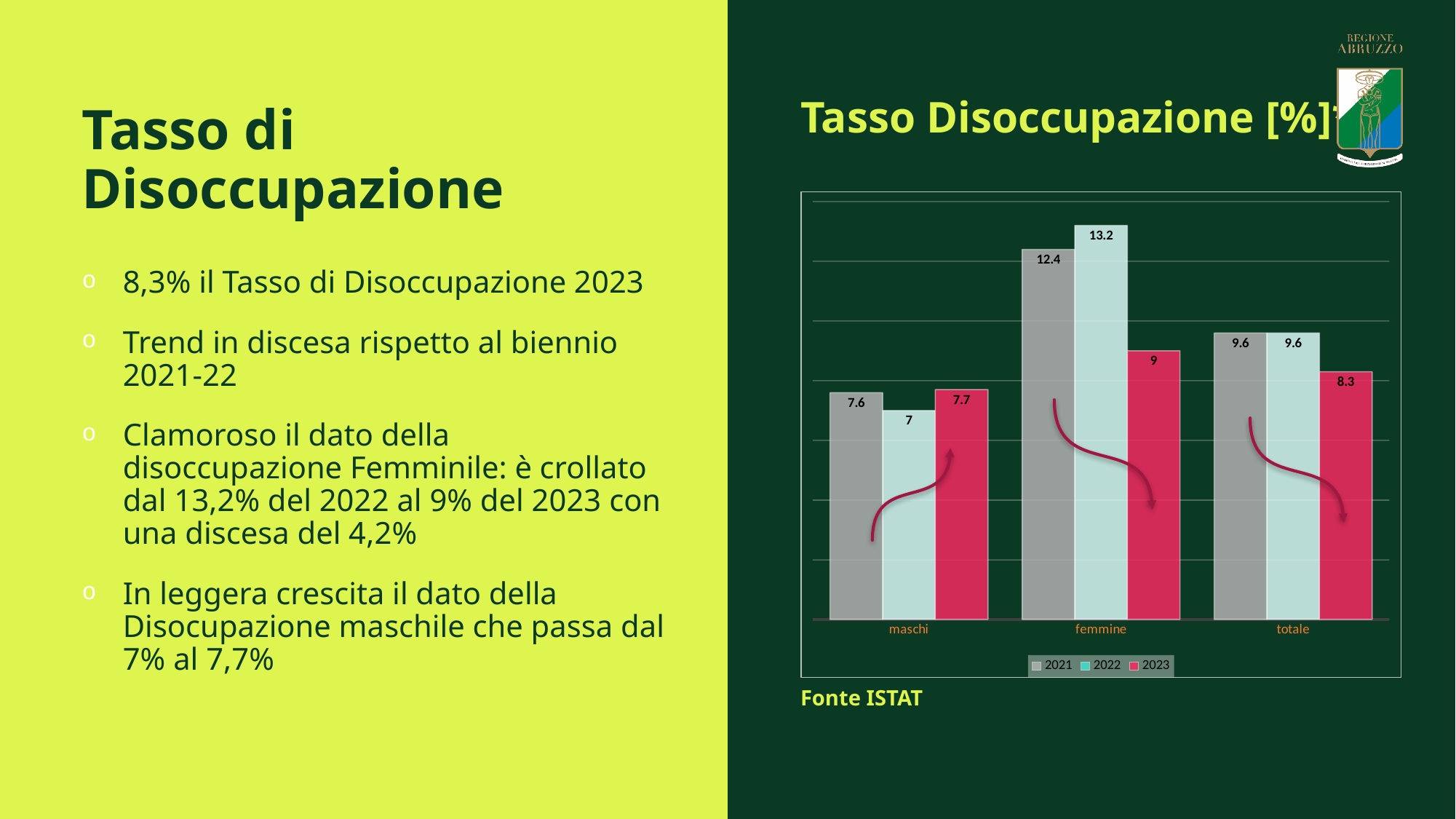
Which is larger: the maschi value for 2021 or for 2023? 2023 Do the totale values rise or fall from 2022 to 2023? fall What is the value for maschi in 2023? 7.7 What is the title of the chart? Tasso Disoccupazione [%] What kind of chart is shown? bar chart Which category has the highest value in 2023? femmine How many series does the legend list? 3 What is the difference between the femmine values for 2022 and 2023? 4.2 Which category has the lowest value in 2022? maschi How many categories are shown on the x axis? 3 What is the value for totale in 2021? 9.6 What is the value for femmine in 2022? 13.2